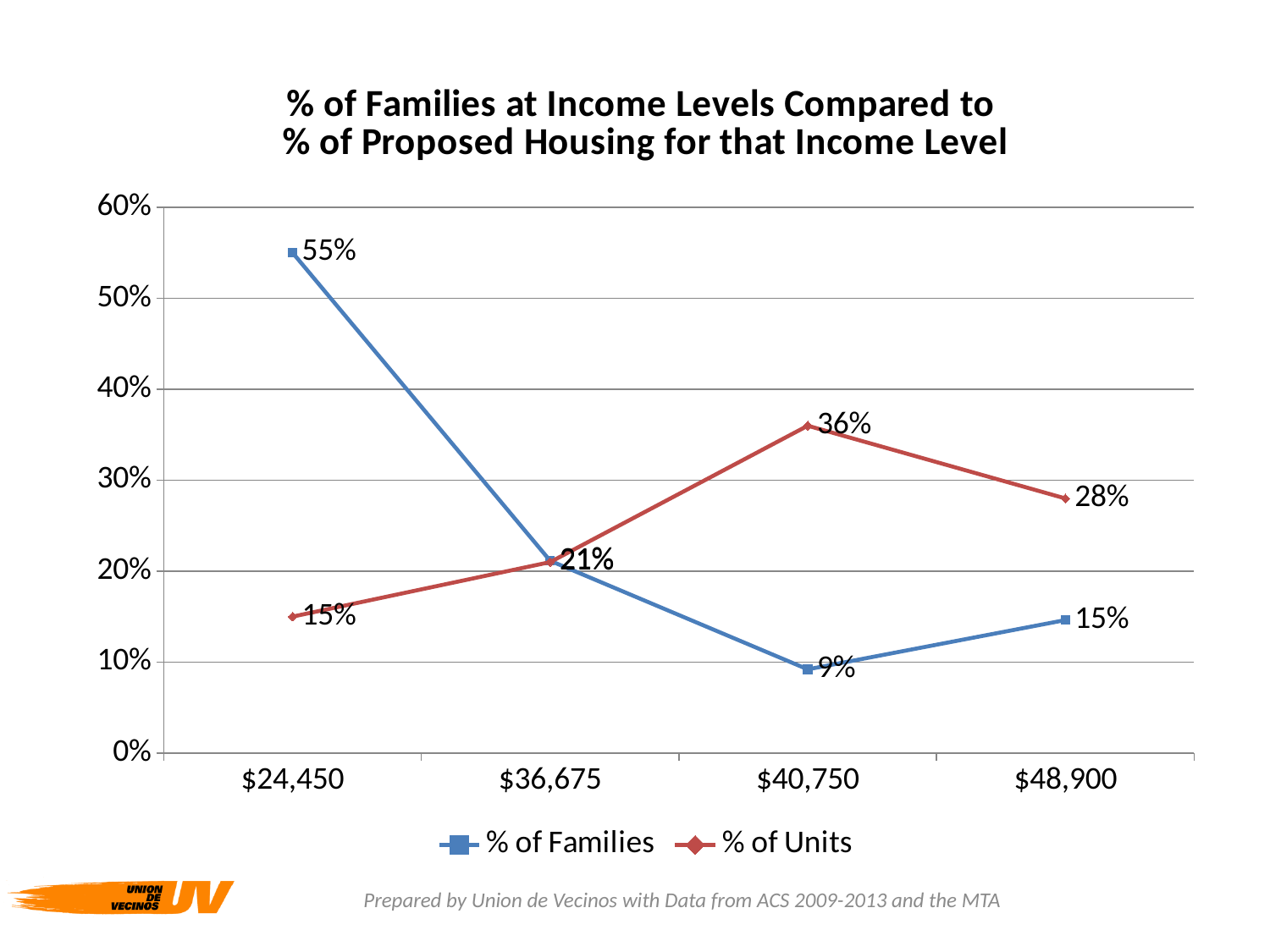
What is the % of Units at the $40,750 income level? 36% At which income level is the % of Families highest? $24,450 How many series does the legend list? 2 Does the % of Families rise or fall from $24,450 to $40,750? Fall At which income level is the % of Units lowest? $24,450 How many income levels are shown on the x axis? 4 What is the % of Families at the $24,450 income level? 55% At the $48,900 income level, which is larger: % of Families or % of Units? % of Units What is the % of Families at the $40,750 income level? 9% What is the % of Units at the $48,900 income level? 28% What is the difference between the % of Families and the % of Units at the $24,450 income level? 40% What kind of chart is shown on the slide? Line chart